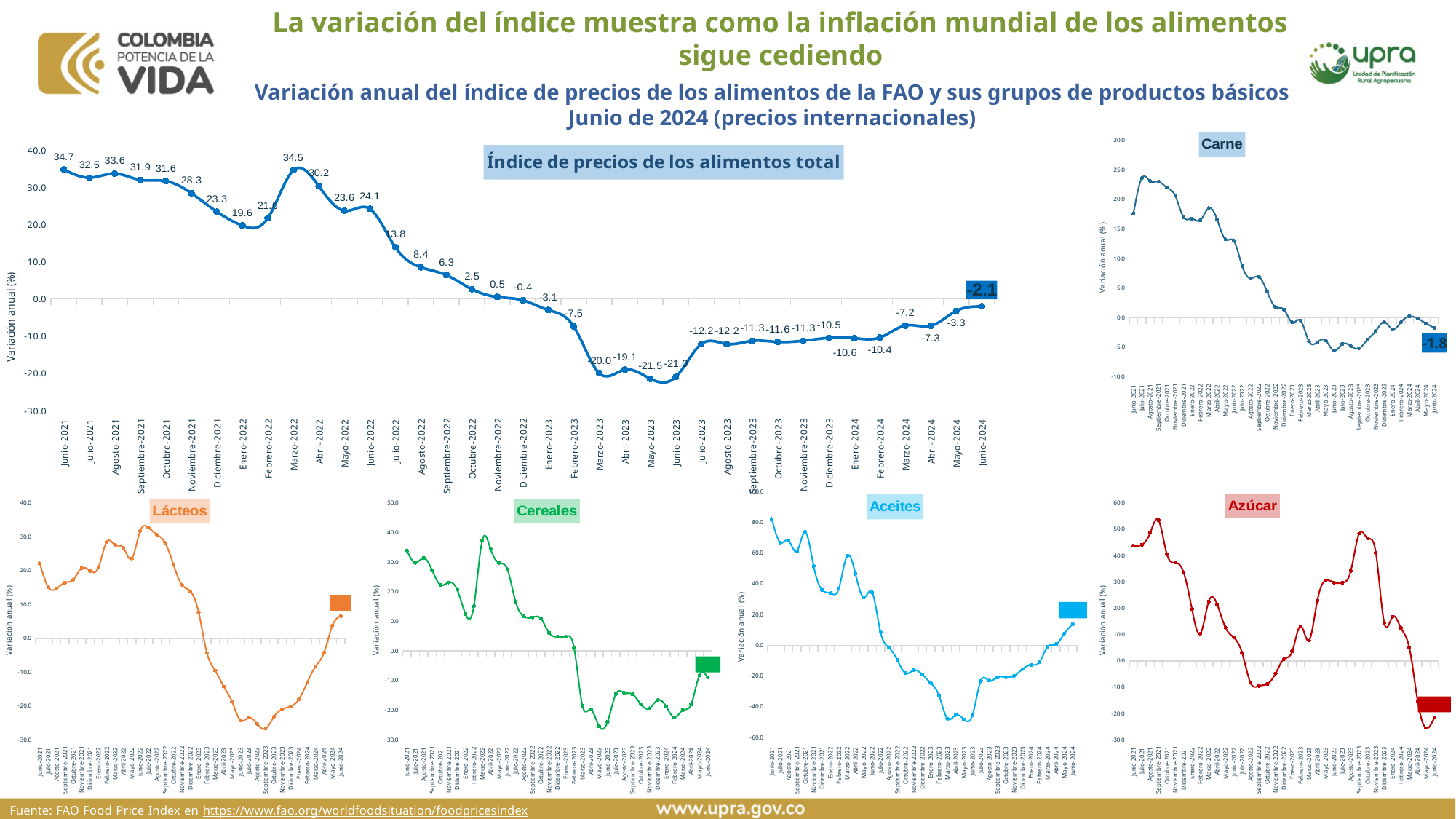
What kind of chart is the 'Azúcar' chart? Line chart In the 'Índice de precios de los alimentos total' chart, what is the value for Junio-2024? -2.1 In the 'Índice de precios de los alimentos total' chart, do the values generally rise or fall from Junio-2021 to Mayo-2023? Fall In the 'Índice de precios de los alimentos total' chart, what is the value for Marzo-2022? 34.5 In the 'Índice de precios de los alimentos total' chart, which month has the lowest value? Mayo-2023 How many monthly data points are plotted in the 'Índice de precios de los alimentos total' chart? 37 In the 'Índice de precios de los alimentos total' chart, what is the value for Julio-2022? 13.8 In the 'Índice de precios de los alimentos total' chart, which is larger, the value for Agosto-2021 or the value for Octubre-2021? Agosto-2021 In the 'Carne' chart, what is the value shown for the last point, Junio-2024? -1.8 In the 'Índice de precios de los alimentos total' chart, what is the difference between the values for Junio-2021 and Junio-2024? 36.8 In the 'Índice de precios de los alimentos total' chart, which month has the highest value? Junio-2021 In the 'Carne' chart, is the value for Junio-2021 greater or less than 10.0? greater